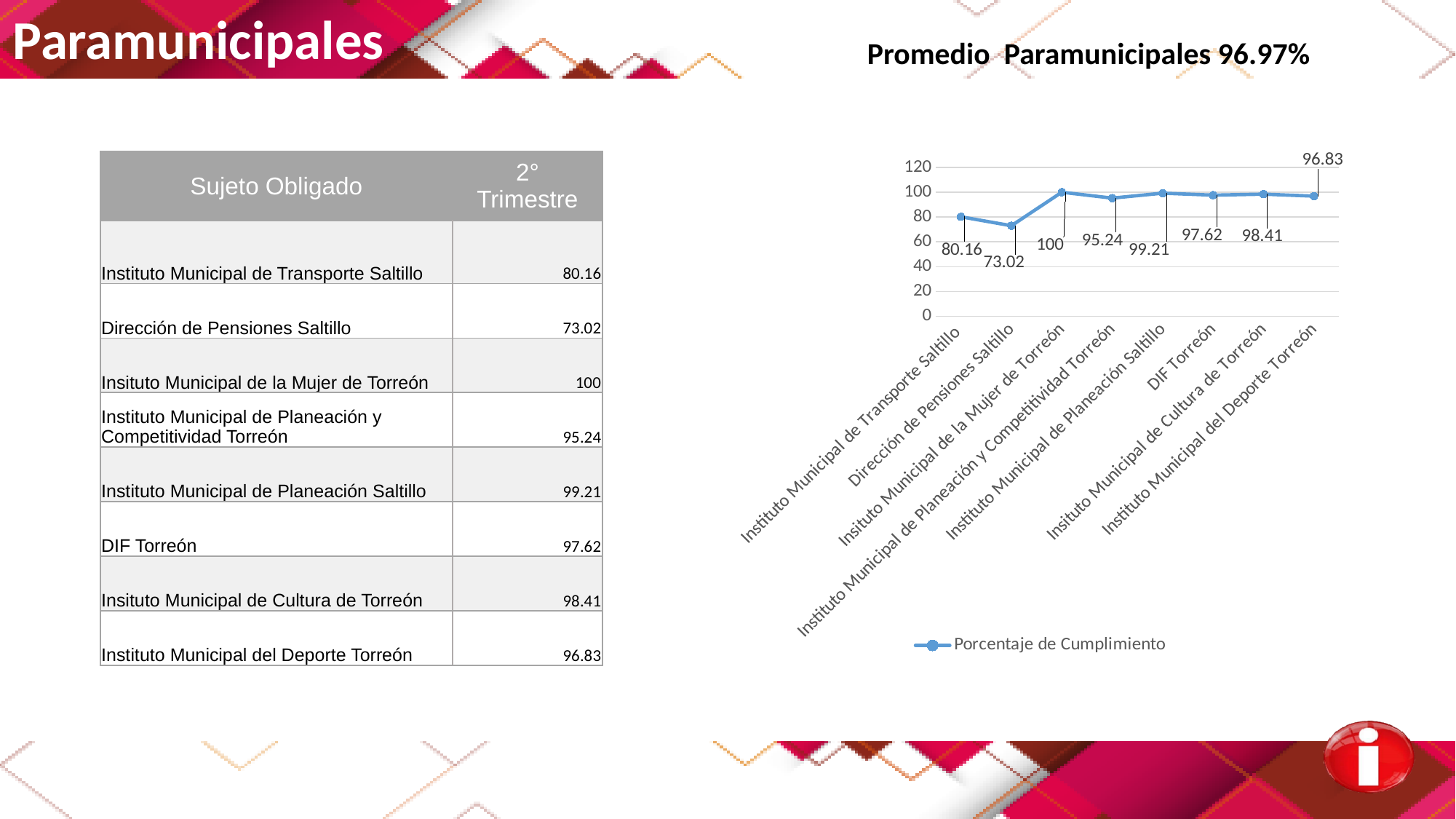
Which is larger, the value for Instituto Municipal de Planeación Saltillo or the value for DIF Torreón? Instituto Municipal de Planeación Saltillo What is the value for Dirección de Pensiones Saltillo? 73.02 Which category has the highest value? Insituto Municipal de la Mujer de Torreón How many categories are plotted on the chart? 8 What kind of chart is shown on the slide? line chart Is the value for Dirección de Pensiones Saltillo greater or less than 80? less What series name does the legend show? Porcentaje de Cumplimiento What is the value for Instituto Municipal de Transporte Saltillo? 80.16 What is the value for Instituto Municipal del Deporte Torreón? 96.83 What is the difference between the values for Instituto Municipal de Transporte Saltillo and Dirección de Pensiones Saltillo? 7.14 What is the value for DIF Torreón? 97.62 Which category has the lowest value? Dirección de Pensiones Saltillo